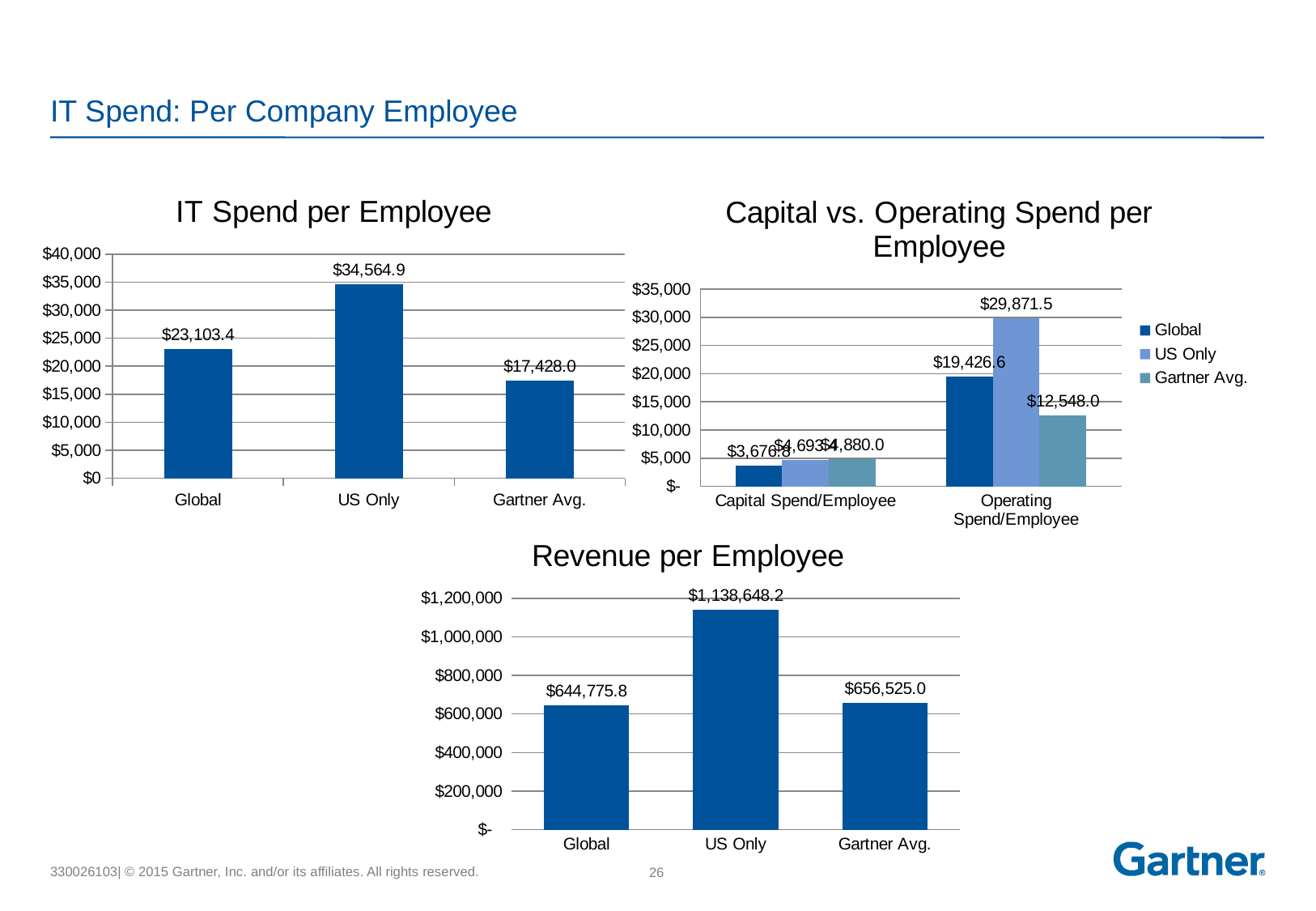
What kind of chart is the Revenue per Employee chart? Bar chart In the Capital vs. Operating Spend per Employee chart, what is the Gartner Avg. value for Operating Spend/Employee? $12,548.0 In the Revenue per Employee chart, which category has the highest value? US Only In the Revenue per Employee chart, what is the difference between the US Only and Gartner Avg. values? $482,123.2 In the Capital vs. Operating Spend per Employee chart, what is the US Only value for Operating Spend/Employee? $29,871.5 In the Revenue per Employee chart, what is the value for Global? $644,775.8 In the IT Spend per Employee chart, what is the difference between the US Only and Global values? $11,461.5 In the Capital vs. Operating Spend per Employee chart, how many series does the legend list? 3 In the IT Spend per Employee chart, what is the value for US Only? $34,564.9 In the Revenue per Employee chart, how many categories are shown on the x axis? 3 In the IT Spend per Employee chart, which category has the lowest value? Gartner Avg. In the Capital vs. Operating Spend per Employee chart, is the Global value for Capital Spend/Employee greater or less than $5,000? less